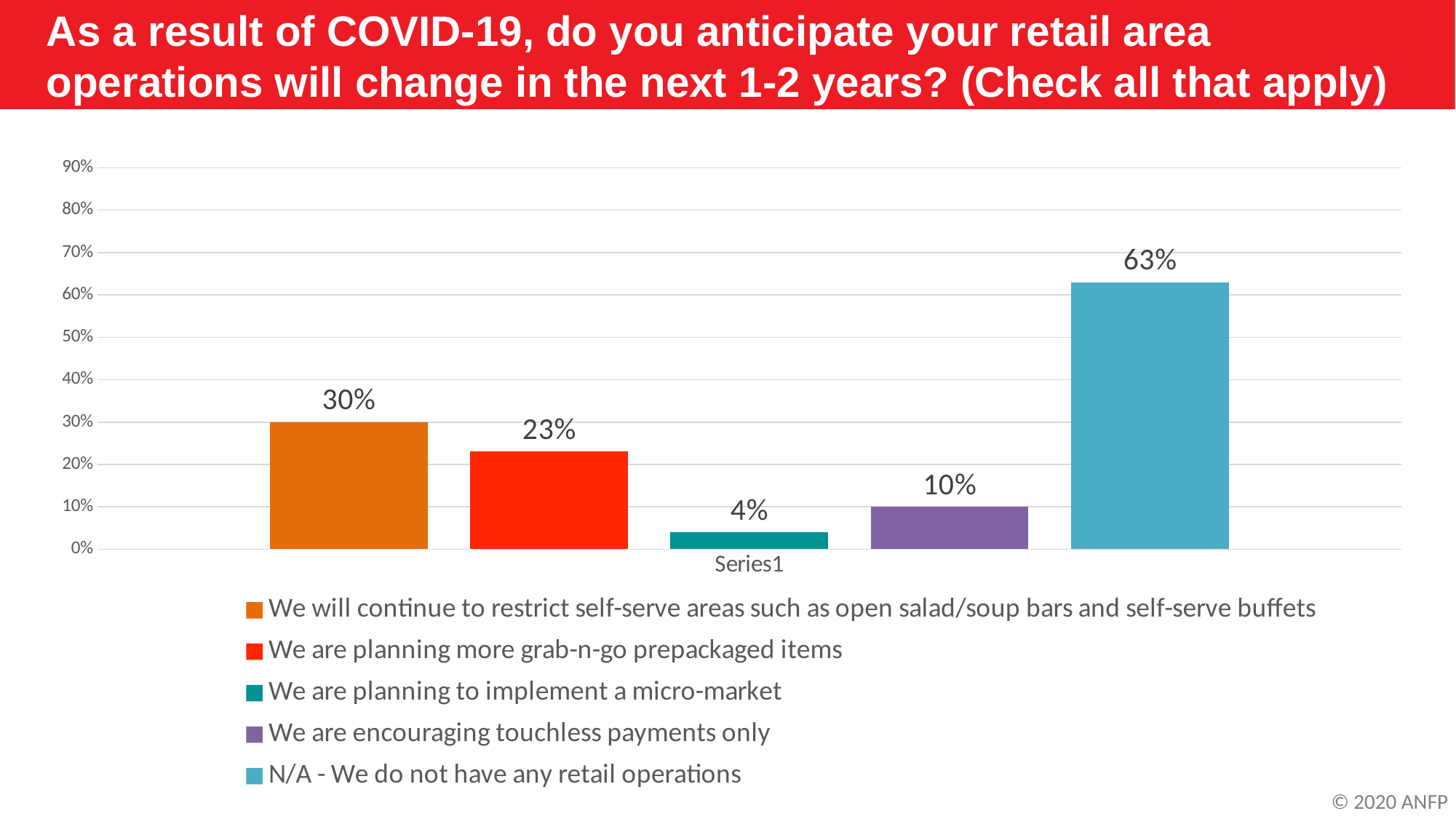
Is the value for 'N/A - We do not have any retail operations' greater or less than 50%? greater What type of chart is shown on the slide? Bar chart How many bars are shown in the chart? 5 Which is larger: the percentage planning more grab-n-go prepackaged items or the percentage encouraging touchless payments only? We are planning more grab-n-go prepackaged items What percentage of respondents are planning to implement a micro-market? 4% Which response option has the highest percentage? N/A - We do not have any retail operations What is the difference in percentage points between 'N/A - We do not have any retail operations' and 'We will continue to restrict self-serve areas'? 33% What colour is the bar for 'We are encouraging touchless payments only'? Purple What percentage of respondents are planning more grab-n-go prepackaged items? 23% Which response option has the lowest percentage? We are planning to implement a micro-market What percentage of respondents said they will continue to restrict self-serve areas such as open salad/soup bars and self-serve buffets? 30% What percentage of respondents are encouraging touchless payments only? 10%